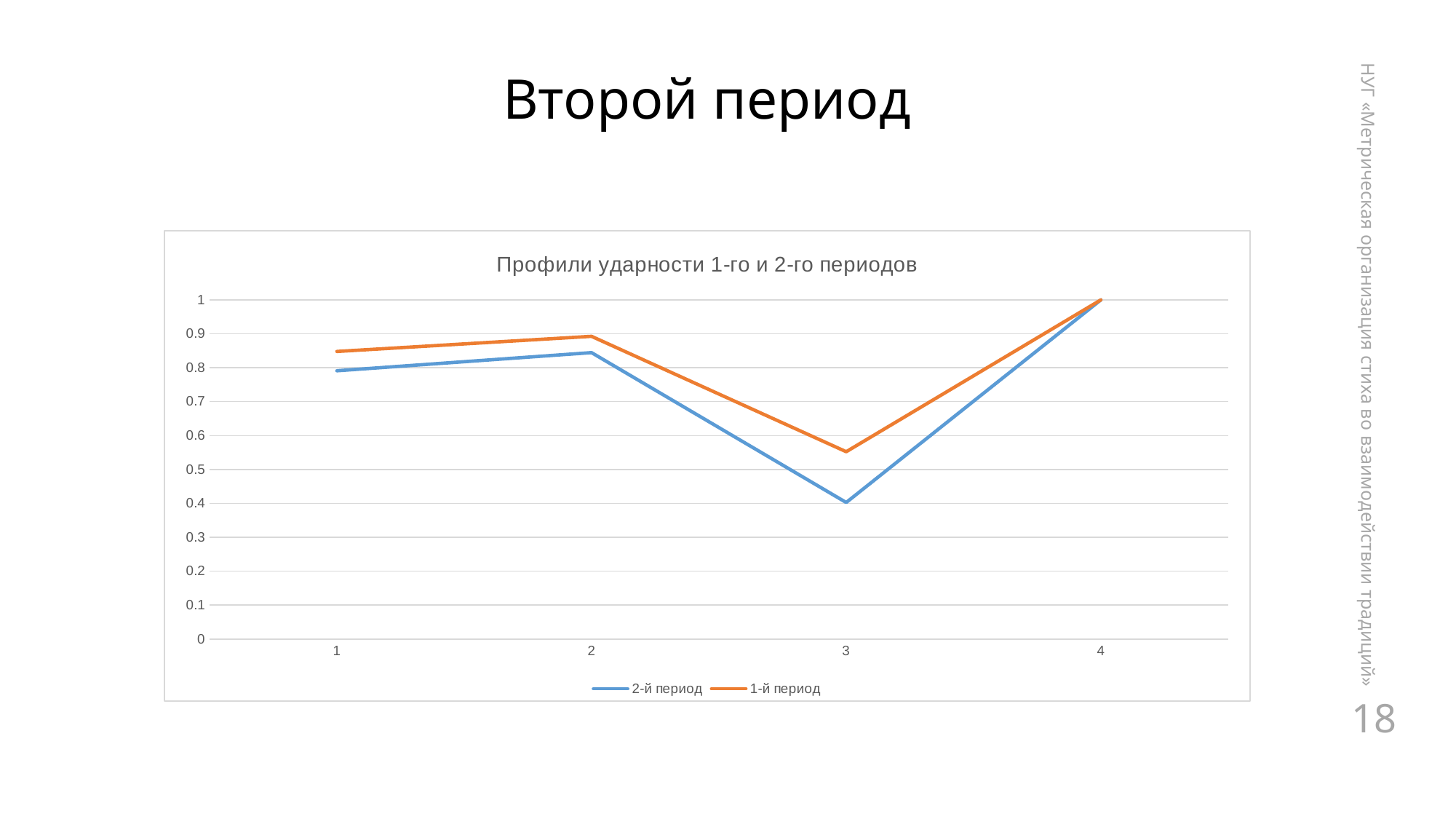
What kind of chart is shown on the slide? line chart Which series is drawn in orange? 1-й период How many series does the legend list? 2 At position 3, which series has the larger value, 1-й период or 2-й период? 1-й период Is the value for 2-й период at position 3 greater or less than 0.5? less At which x-axis position is the value for 1-й период lowest? 3 At which x-axis position is the value for 2-й период lowest? 3 How many points are plotted along the x axis for each series? 4 Is the value for 1-й период at position 3 greater or less than 0.5? greater Do the values for 2-й период rise or fall from position 3 to position 4? rise What is the value for 2-й период at position 4? 1 What is the title of the chart? Профили ударности 1-го и 2-го периодов